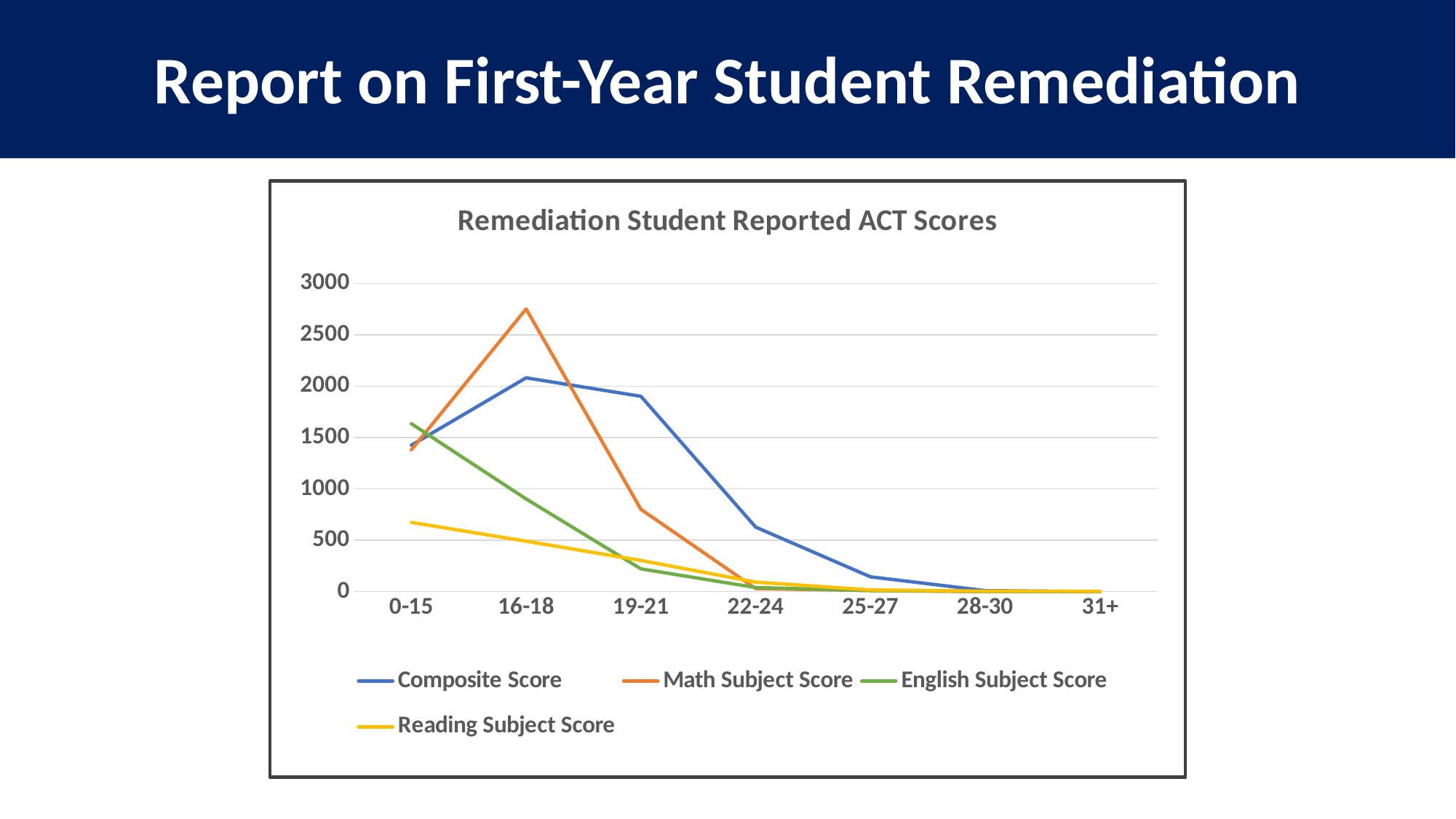
How many ACT score ranges are shown on the x axis? 7 In which score range does the Math Subject Score series reach its highest value? 16-18 At 16-18, which is larger: the Math Subject Score or the Composite Score? Math Subject Score In which score range does the English Subject Score series reach its highest value? 0-15 Does the Reading Subject Score series rise or fall from 0-15 to 31+? fall Is the Math Subject Score value for 16-18 greater or less than 2500? greater What kind of chart is shown on the slide? line chart How many series does the legend list? 4 In which score range does the Composite Score series reach its highest value? 16-18 What is the title of the chart? Remediation Student Reported ACT Scores Is the Composite Score value for 19-21 greater or less than 2000? less At 0-15, which is larger: the English Subject Score or the Reading Subject Score? English Subject Score